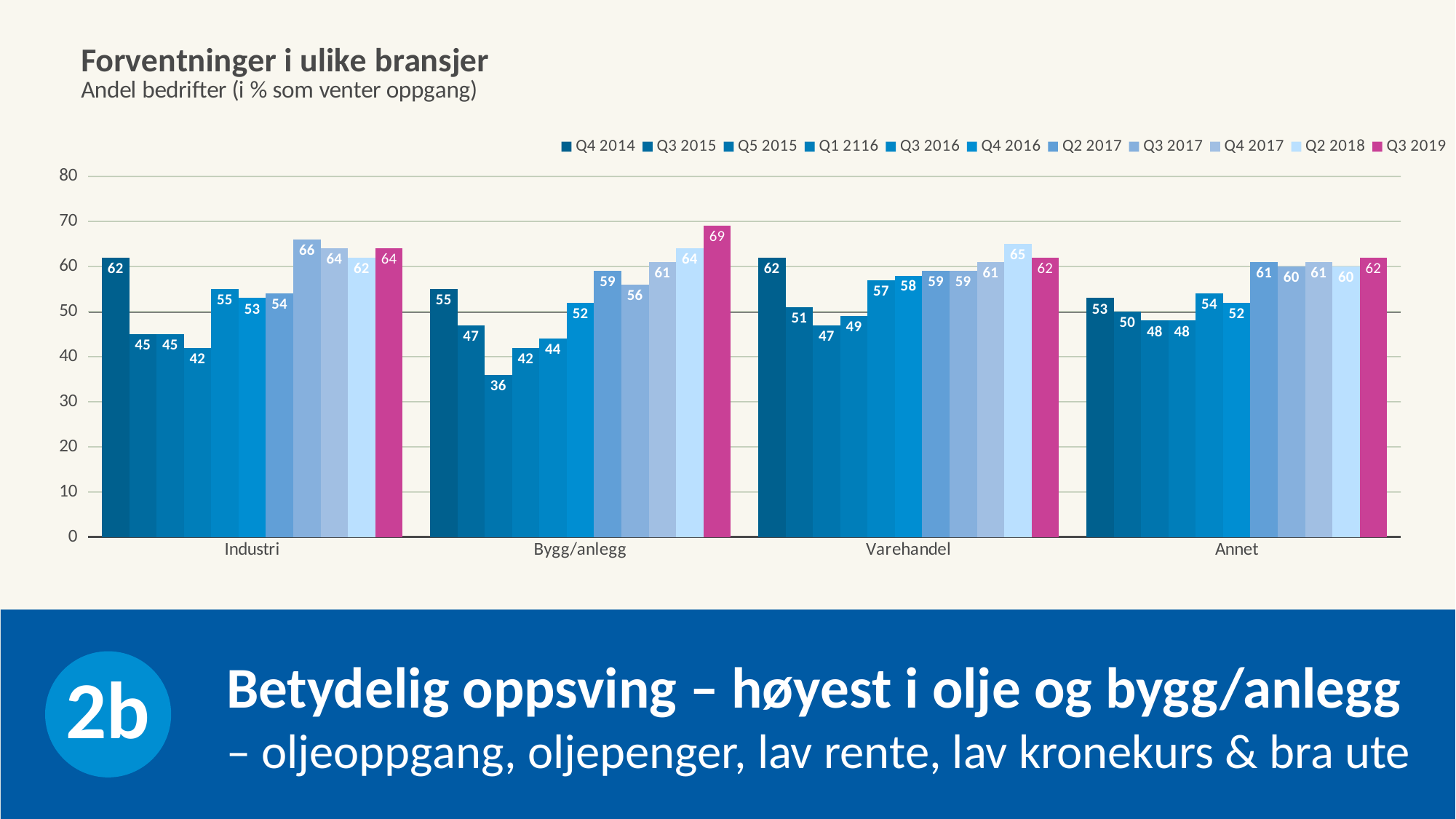
Which category has the lowest Q5 2015 value? Bygg/anlegg What is the Q4 2014 value for Industri? 62 What is the Q2 2018 value for Varehandel? 65 Which is larger for Annet: the Q4 2014 value or the Q3 2019 value? Q3 2019 What is the subtitle of the chart? Andel bedrifter (i % som venter oppgang) What is the difference between the Q3 2019 value and the Q2 2018 value for Bygg/anlegg? 5 Which category has the highest Q3 2019 value? Bygg/anlegg What type of chart is shown on the slide? bar chart What is the Q3 2019 value for Bygg/anlegg? 69 How many series does the legend list? 11 Is the Q5 2015 value for Bygg/anlegg greater or less than 40? less How many industry categories are shown on the x axis? 4